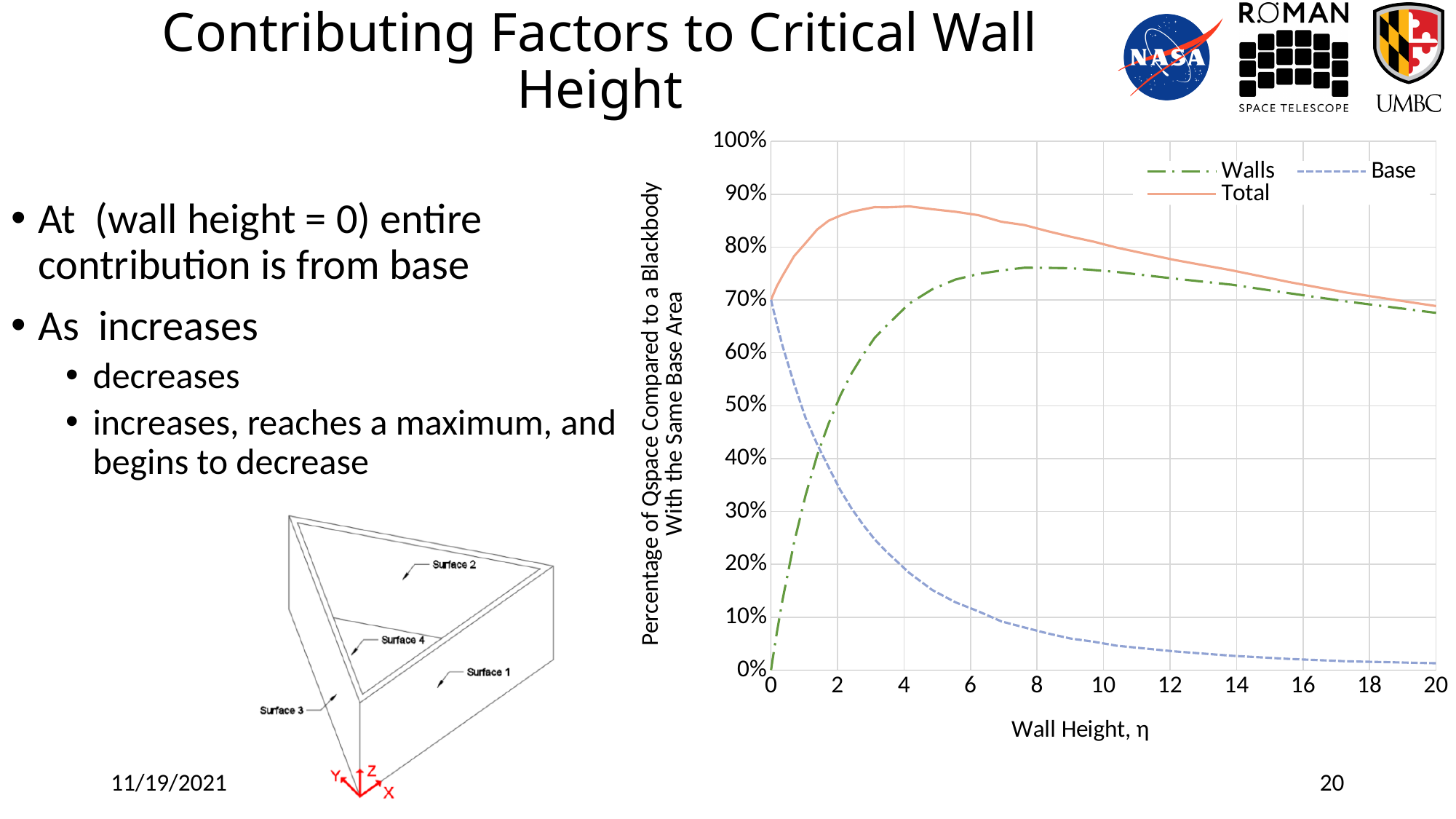
Does the Base series rise or fall as wall height increases? fall What are the names of the series listed in the chart legend? Walls, Base, Total What is the title of the x axis of the chart? Wall Height, η What kind of chart is shown on the slide? line chart Is the value of the Base series at wall height 10 greater or less than 10%? less Is the value of the Total series at wall height 4 greater or less than 80%? greater How many series does the chart legend list? 3 Is the value of the Base series at wall height 2 greater or less than 40%? less What is the value of the Walls series at wall height 0? 0% What is the value of the Base series at wall height 0? 70% At wall height 10, which series has the larger value, Walls or Base? Walls